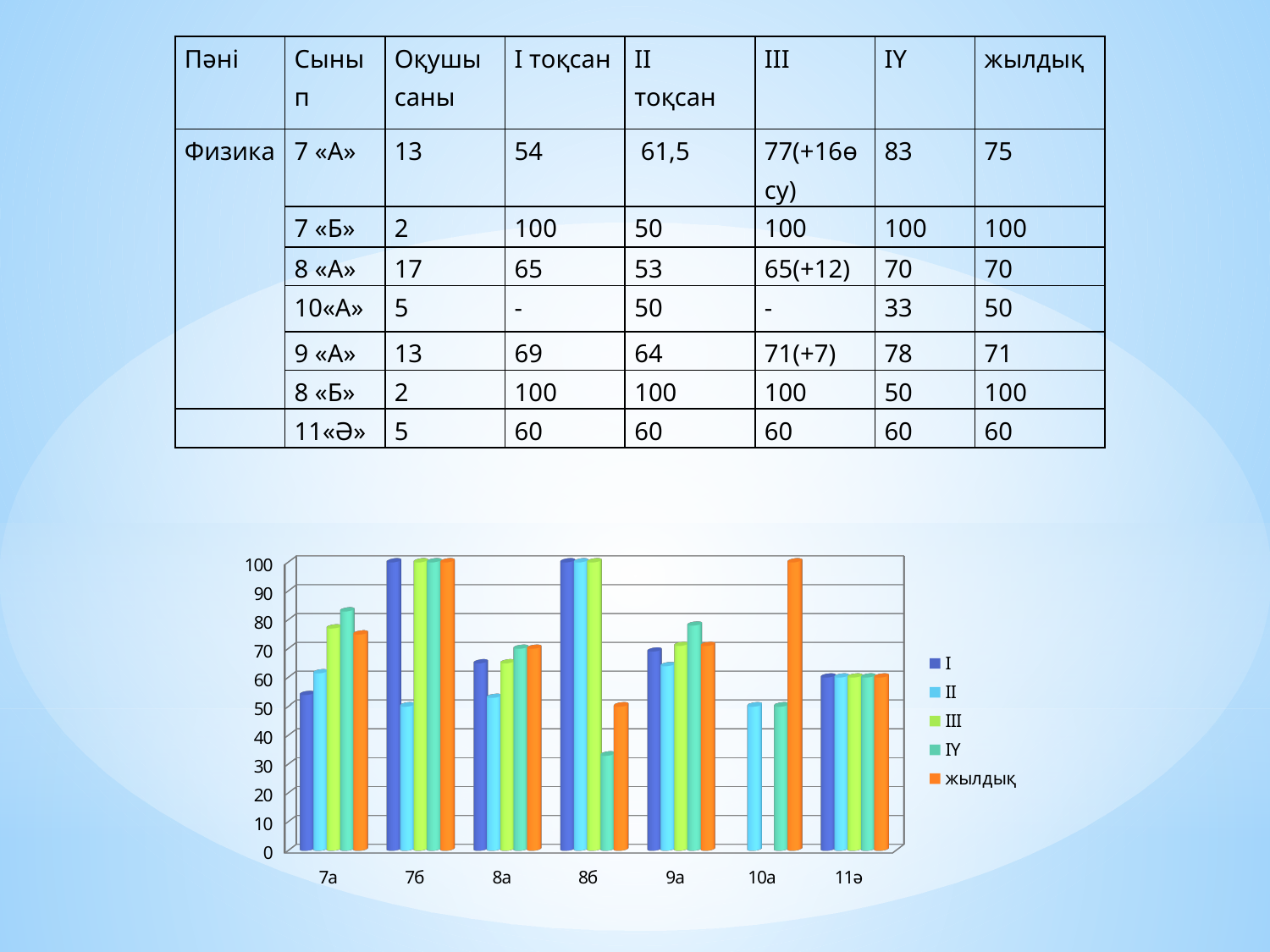
What are the legend entries of the chart? I, II, III, IY, жылдық What is the value of series жылдық for 11ә in the chart? 60 In the chart, what is the difference between series I and series II for 7б? 50 In the chart, which series has the lowest value for 8б? IY In the chart, which is larger for 8а: series I or series II? I In the chart, which series has the lowest value for 7а? I How many series does the chart legend list? 5 What is the value of series II for 10а in the chart? 50 In the chart, is the value of series III for 7а greater or less than 70? greater What kind of chart is shown on the slide? bar chart What is the value of series I for 7б in the chart? 100 How many class categories are shown along the x axis of the chart? 7